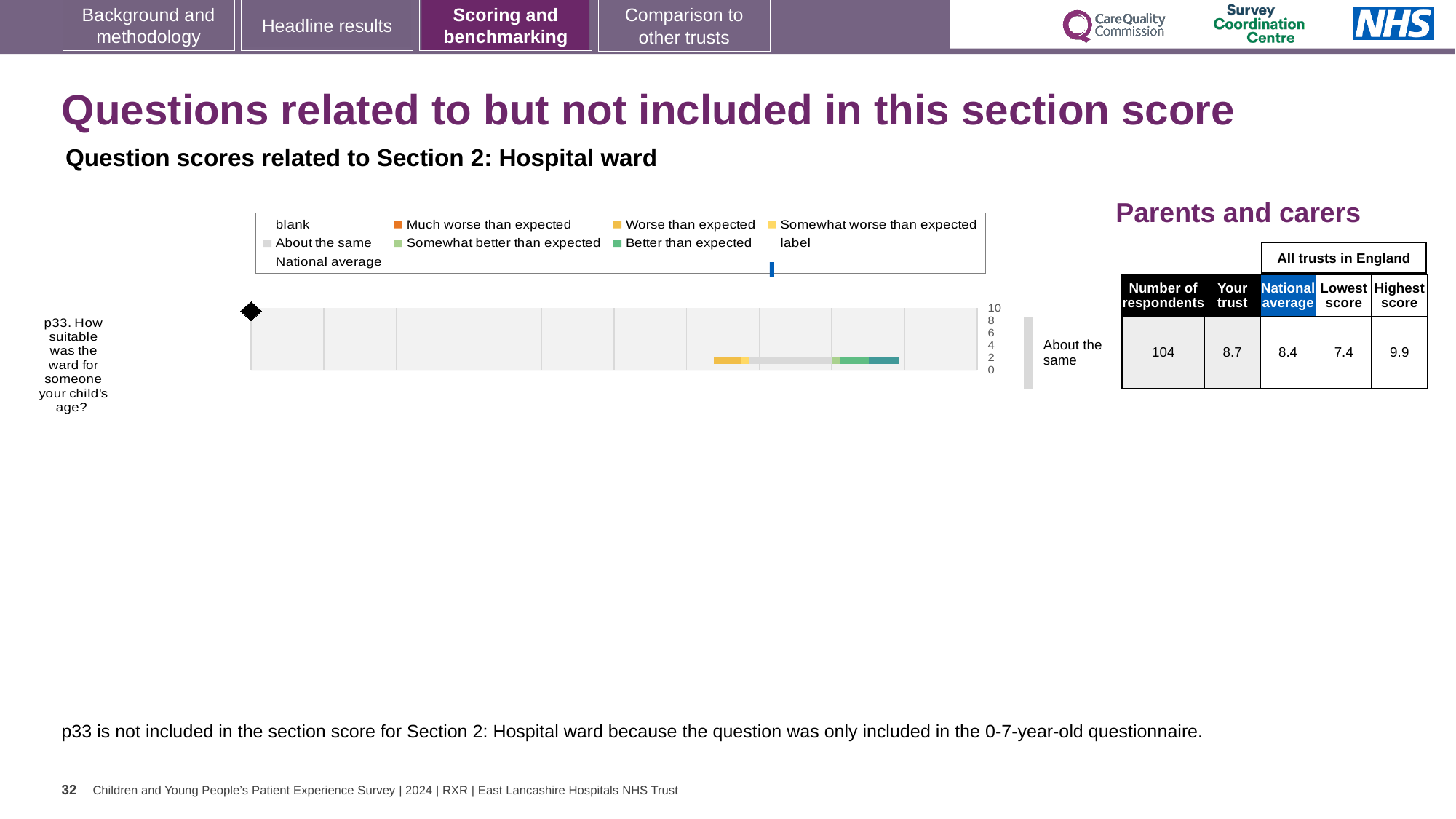
How many respondents answered p33? 104 What is the highest score among all trusts in England for p33? 9.9 What kind of chart is used to show the p33 question score? bar chart What is the 'Your trust' score for p33? 8.7 Which benchmark band does the trust's p33 score fall into? About the same What is the lowest score among all trusts in England for p33? 7.4 What is the national average score for p33? 8.4 What is the difference between the highest and lowest trust scores for p33? 2.5 Which legend entry is shown in dark orange? Much worse than expected How many questions are plotted in the chart? 1 Is the trust's score for p33 higher or lower than the national average? higher Which question is plotted in the chart? p33. How suitable was the ward for someone your child's age?